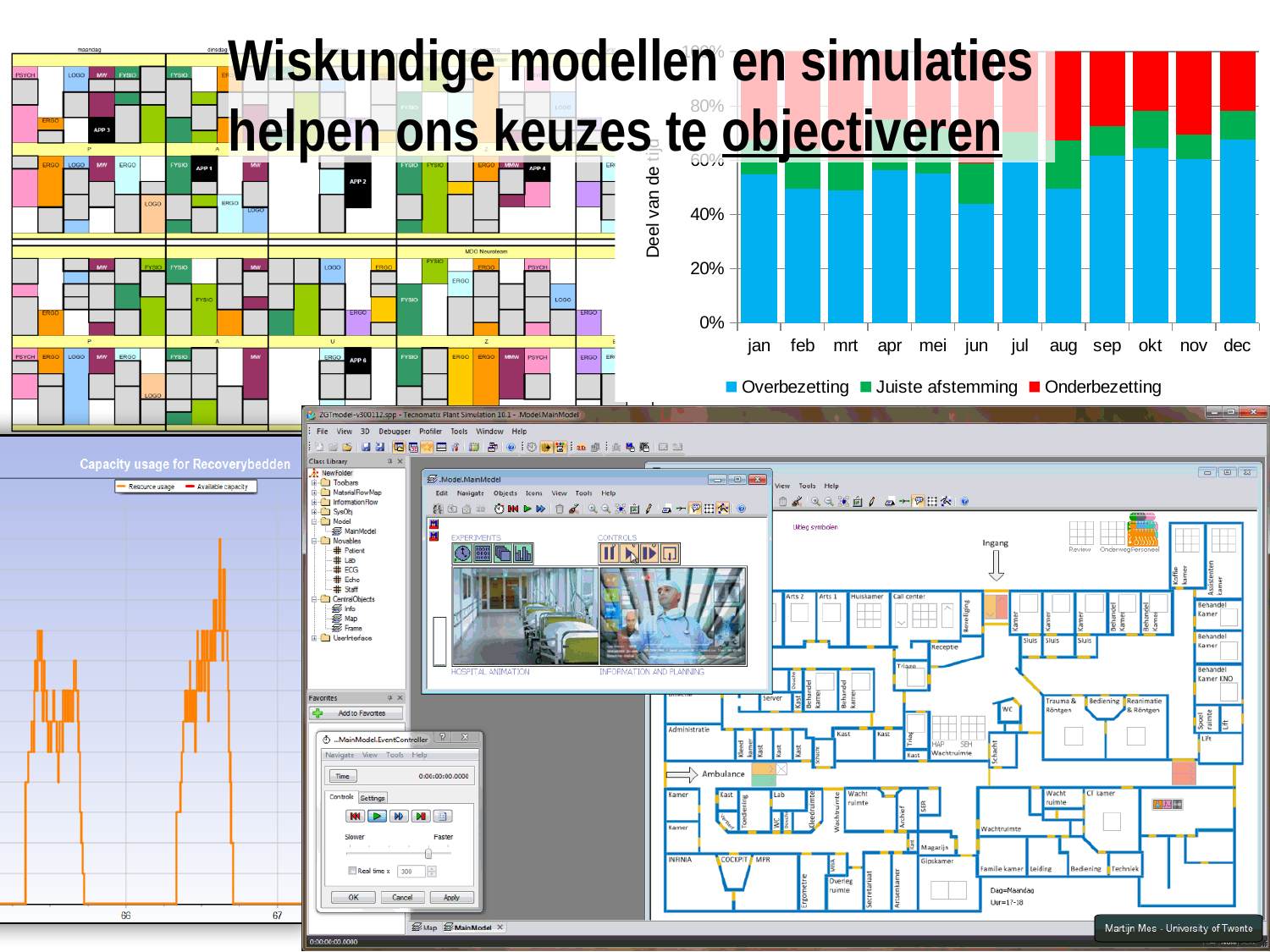
What kind of chart is the chart in the top right of the slide with months on the x axis? stacked bar chart In the top-right stacked bar chart, is the Overbezetting value for dec greater or less than 60%? greater In the top-right stacked bar chart, how many months are shown on the x axis? 12 In the top-right stacked bar chart, is the Overbezetting value for jan greater or less than 40%? greater In the top-right stacked bar chart, which month has a larger Overbezetting share, jun or dec? dec In the bottom-left chart titled 'Capacity usage for Recoverybedden', how many series does the legend list? 2 In the top-right stacked bar chart, is the Overbezetting value for jun greater or less than 60%? less In the top-right stacked bar chart, what is the title of the vertical axis? Deel van de tijd What is the title of the chart in the bottom left of the slide? Capacity usage for Recoverybedden In the top-right stacked bar chart, which month has a larger Onderbezetting share, aug or dec? aug In the top-right stacked bar chart, how many series does the legend list? 3 In the top-right stacked bar chart, which month has the lowest Overbezetting share? jun